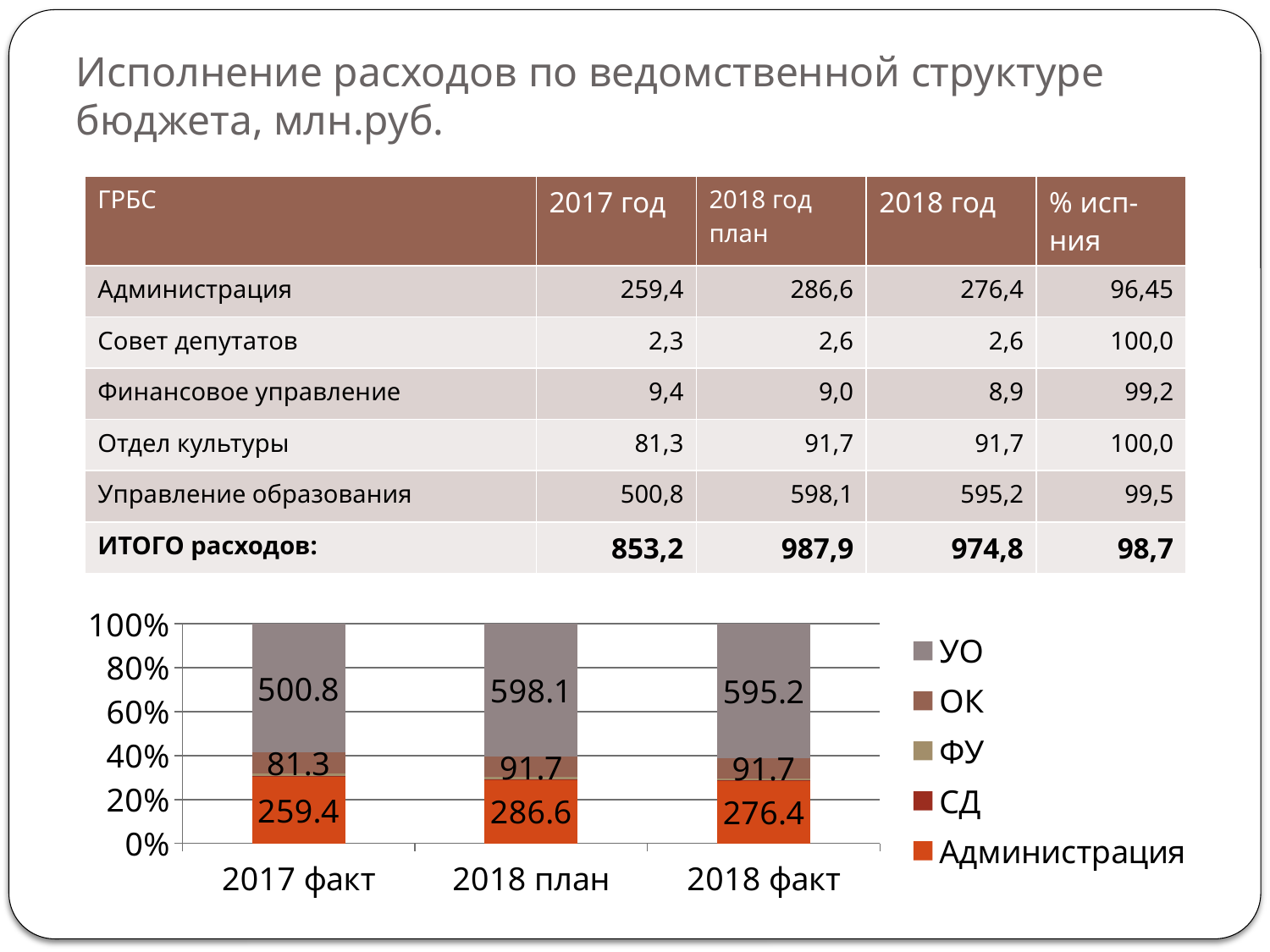
In the bar chart, what is the data label for ОК in the 2018 факт bar? 91.7 In the bar chart, what is the data label for Администрация in the 2018 план bar? 286.6 How many categories are shown on the x axis of the bar chart? 3 What kind of chart is shown at the bottom of the slide? 100% stacked bar chart In the bar chart, what is the difference between the УО labels for 2018 план and 2018 факт? 2.9 In the bar chart, is the Администрация label larger for 2017 факт or for 2018 факт? 2018 факт In the bar chart, what is the data label for УО in the 2018 факт bar? 595.2 In the bar chart, which category has the lowest labelled value for Администрация? 2017 факт Which series is listed last in the legend of the bar chart? Администрация In the bar chart, which category has the highest labelled value for УО? 2018 план In the bar chart, what is the data label for УО in the 2017 факт bar? 500.8 How many series does the legend of the bar chart list? 5